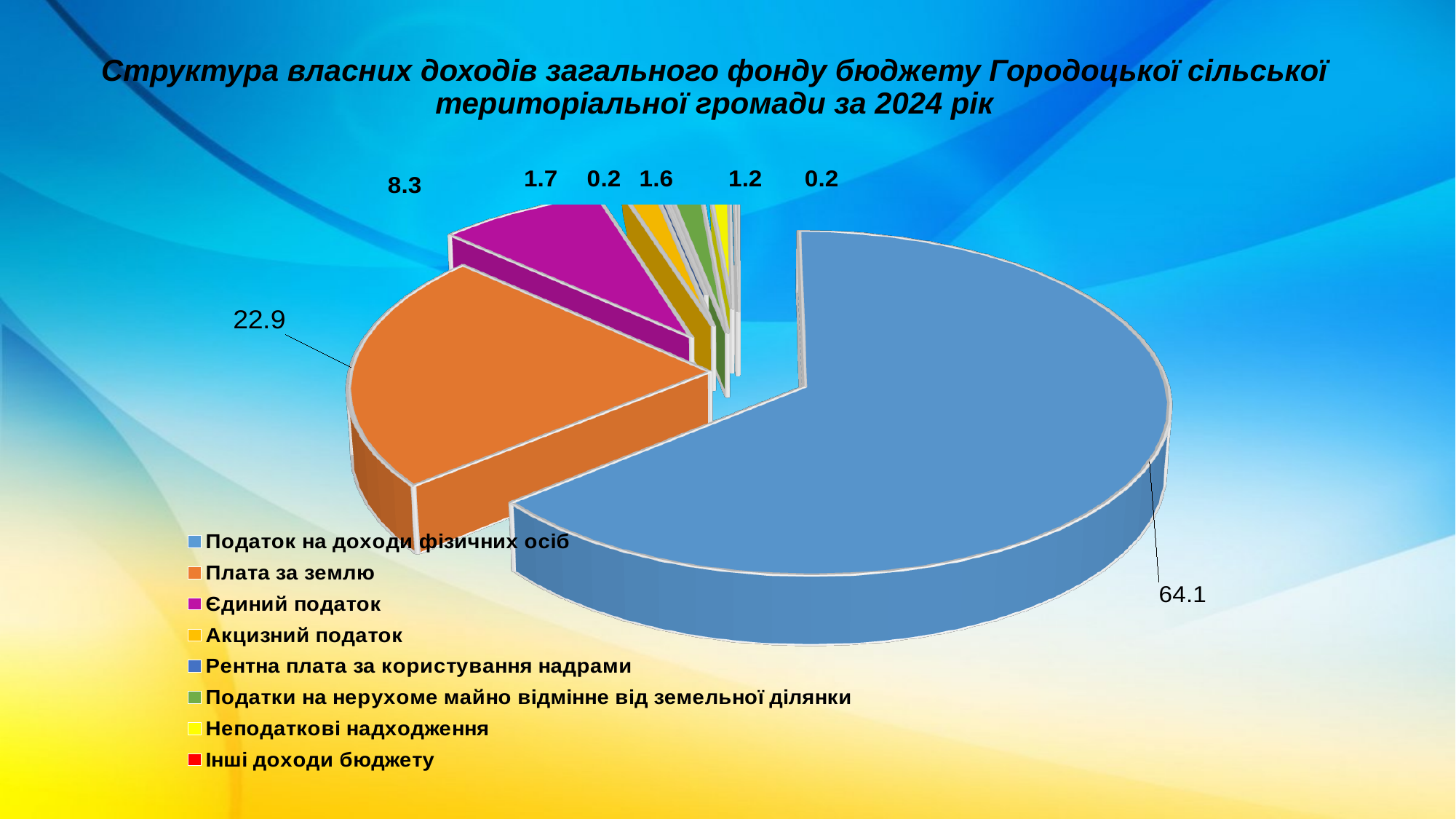
What is the value shown for Податок на доходи фізичних осіб? 64.1 What is the difference between the values for Плата за землю and Єдиний податок? 14.6 Which category has the largest slice of the pie? Податок на доходи фізичних осіб What is the smallest value labelled on the pie chart? 0.2 Which is larger, Плата за землю or Єдиний податок? Плата за землю What is the difference between the values for Податок на доходи фізичних осіб and Плата за землю? 41.2 What is the value shown for Єдиний податок? 8.3 What colour is the slice for Плата за землю? orange How many categories does the legend of the pie chart list? 8 For which year does the chart title say the income structure is shown? 2024 What kind of chart is shown on the slide? pie chart What is the value shown for Плата за землю? 22.9